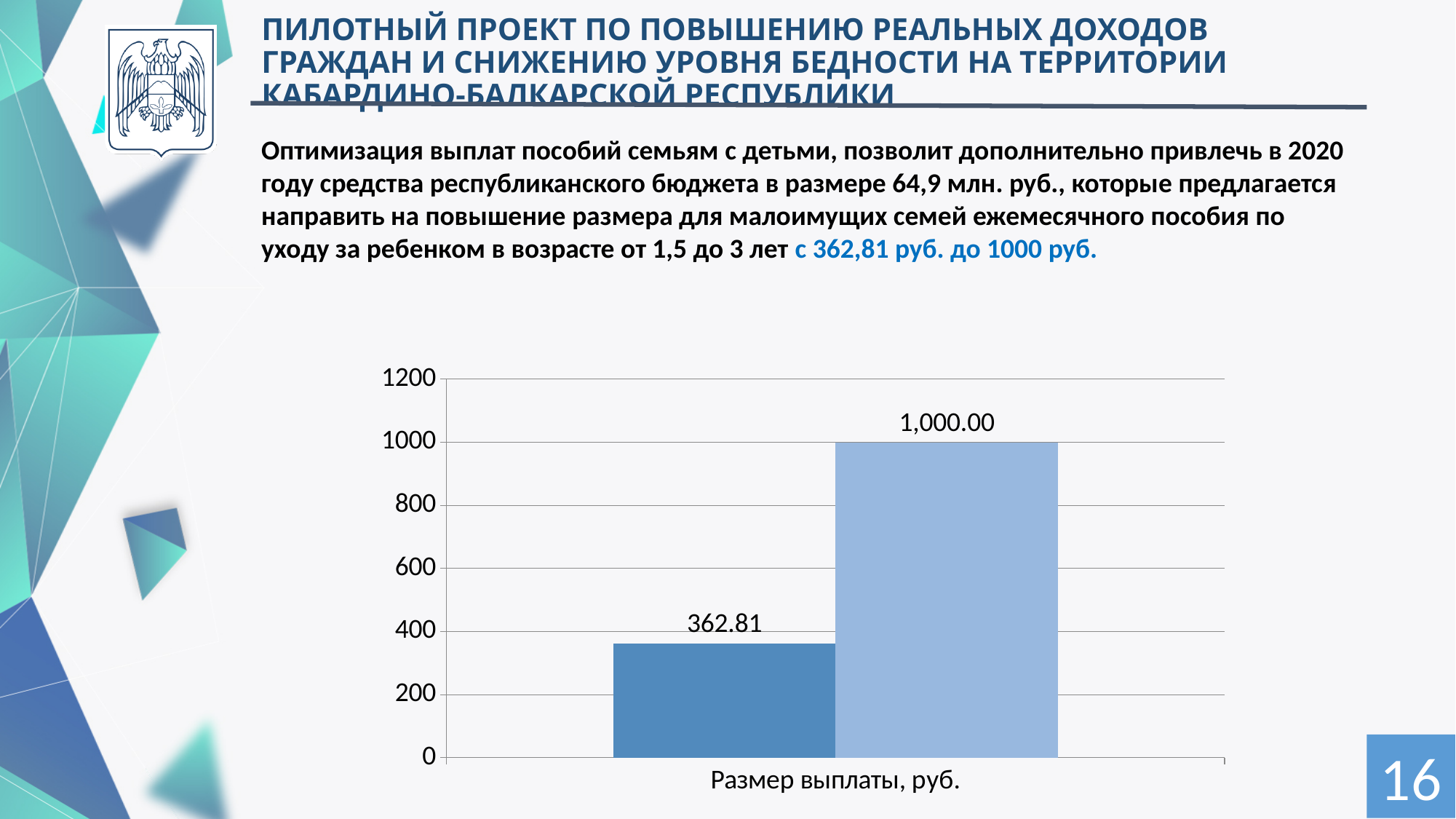
Which bar is taller, the left dark blue bar or the right light blue bar? the right light blue bar What is the value shown on the left (dark blue) bar? 362.81 How many bars are plotted in the chart? 2 Is the value of the left bar greater or less than 400? less What kind of chart is shown on the slide? bar chart What is the value shown on the right (light blue) bar? 1,000.00 What is the maximum value shown on the y axis of the chart? 1200 Is the value of the right bar greater or less than 800? greater What is the highest value shown in the chart? 1,000.00 What is the difference between the two bar values in the chart? 637.19 What is the category label shown on the x axis of the chart? Размер выплаты, руб. What is the lowest value shown in the chart? 362.81